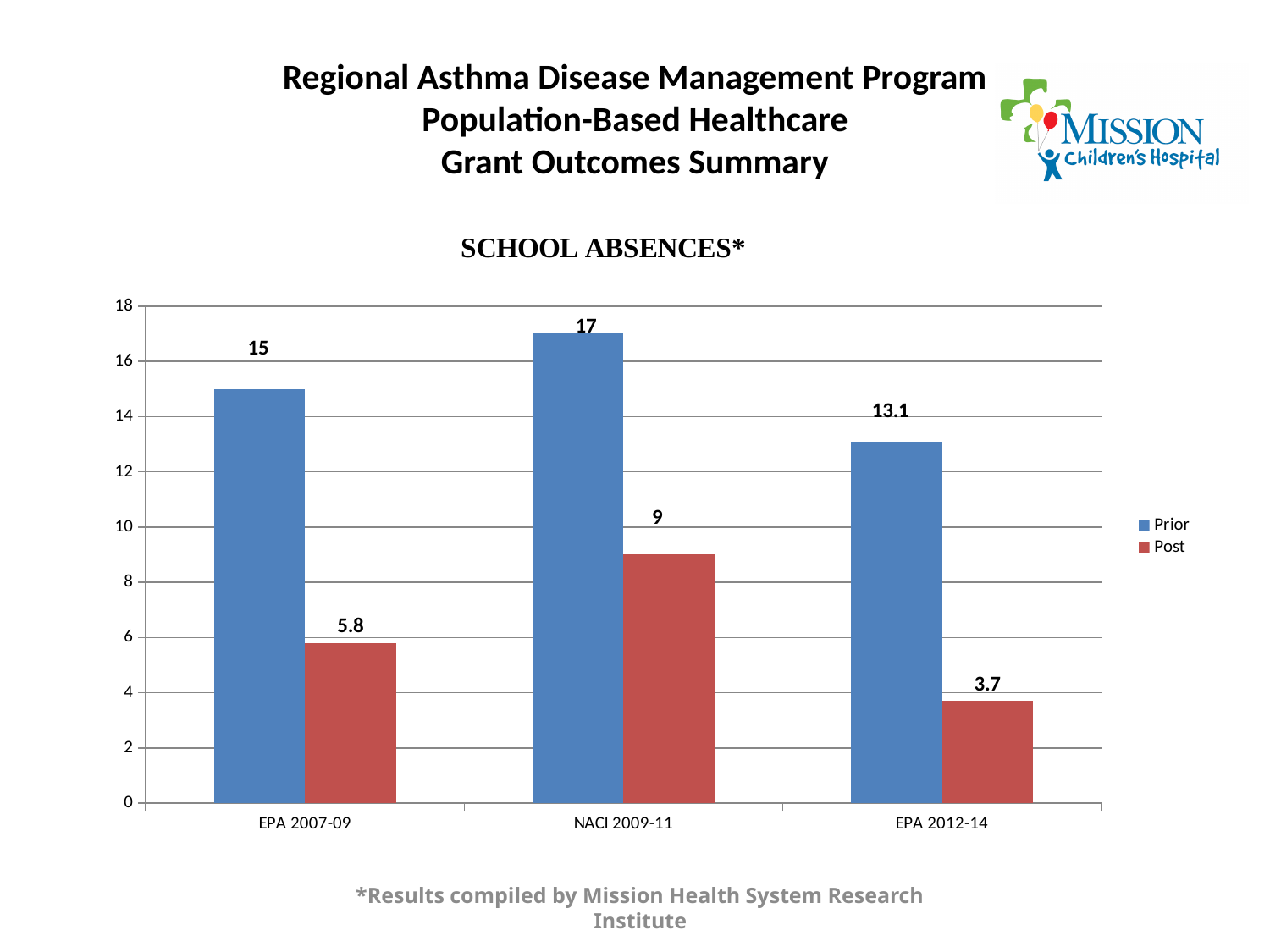
What is the Post value for NACI 2009-11? 9 How many series does the legend list? 2 Which is larger, the Post value for EPA 2007-09 or the Post value for NACI 2009-11? NACI 2009-11 Which category has the highest Prior value? NACI 2009-11 What is the Post value for EPA 2012-14? 3.7 What kind of chart is this? Bar chart What is the Prior value for EPA 2007-09? 15 Which category has the lowest Post value? EPA 2012-14 How many categories are shown on the x axis? 3 What is the difference between the Prior and Post values for EPA 2007-09? 9.2 Do the Post values rise or fall from NACI 2009-11 to EPA 2012-14? Fall What is the title of the chart? SCHOOL ABSENCES*